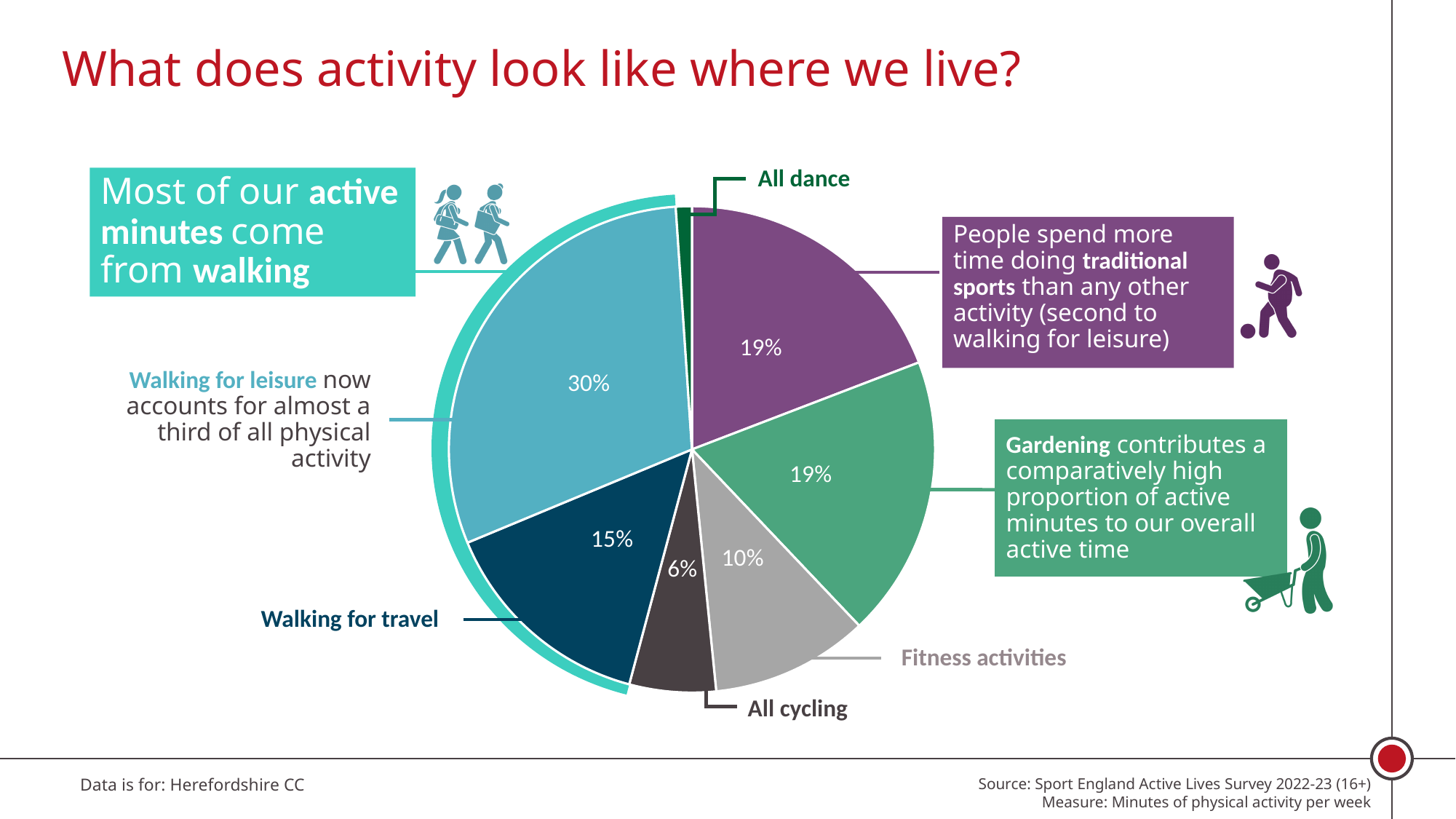
What share of active minutes does walking for leisure account for? 30% What percentage is shown for walking for travel? 15% What percentage is shown for fitness activities? 10% What colour is the slice for gardening? green Which activity has the smallest slice of the pie? All dance What kind of chart is shown on the slide? pie chart Which activity has the largest slice of the pie? Walking for leisure What percentage is shown for gardening? 19% How many slices does the pie chart have? 7 What is the difference in percentage points between walking for leisure and walking for travel? 15 Which is larger, the slice for fitness activities or the slice for all cycling? Fitness activities What percentage is shown for all cycling? 6%